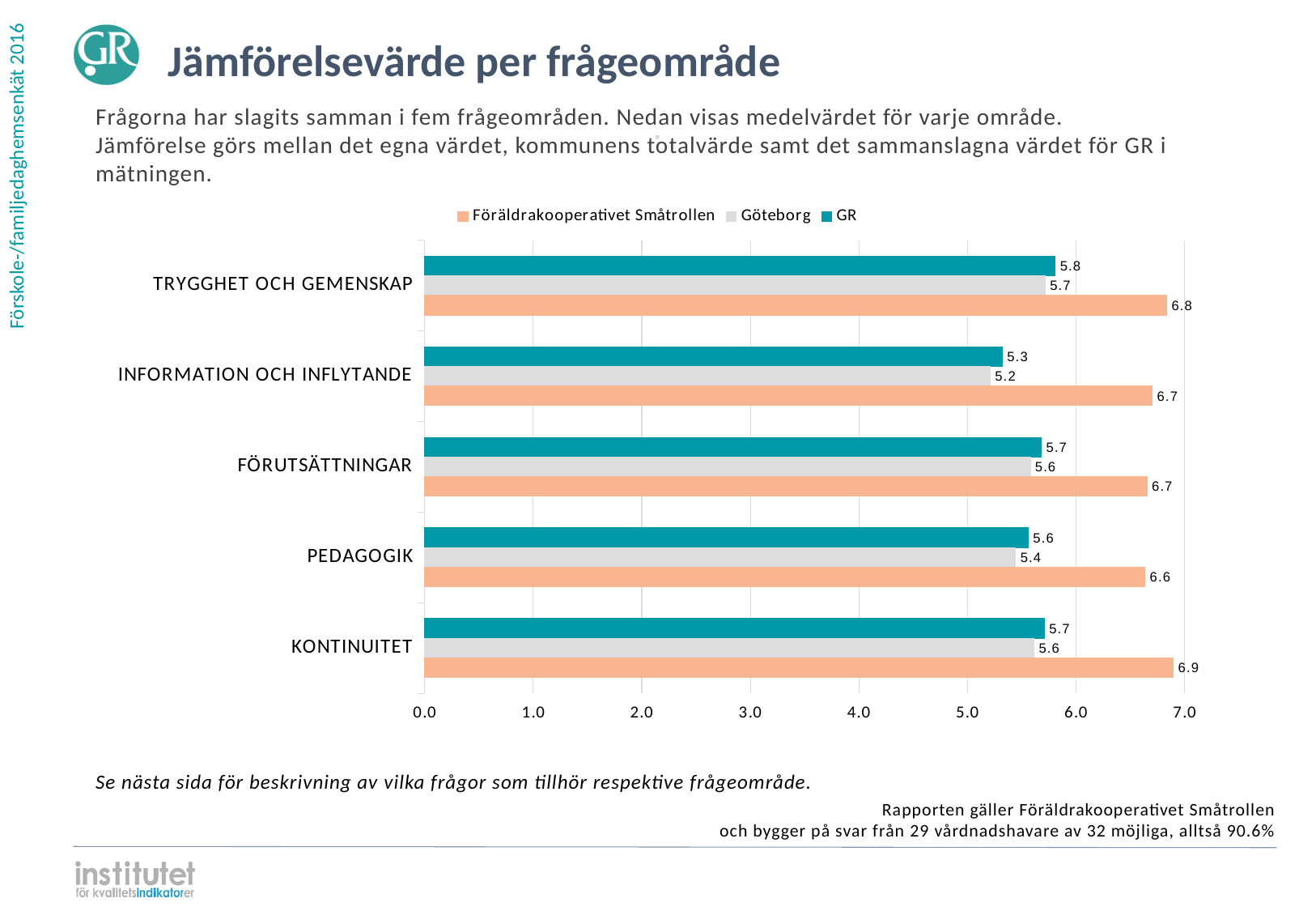
How many categories are shown on the chart? 5 What is the value for Föräldrakooperativet Småtrollen in the TRYGGHET OCH GEMENSKAP category? 6.8 What is the value for Göteborg in the INFORMATION OCH INFLYTANDE category? 5.2 Which category has the lowest value for GR? INFORMATION OCH INFLYTANDE What is the value for GR in the PEDAGOGIK category? 5.6 What kind of chart is shown on the slide? bar chart Which is larger in the KONTINUITET category: the value for GR or the value for Göteborg? GR Is the value for Föräldrakooperativet Småtrollen in the FÖRUTSÄTTNINGAR category greater or less than 6.0? greater What is the title of the slide? Jämförelsevärde per frågeområde What is the difference between the Föräldrakooperativet Småtrollen value and the Göteborg value in the PEDAGOGIK category? 1.2 Which category has the highest value for Föräldrakooperativet Småtrollen? KONTINUITET How many series does the legend list? 3